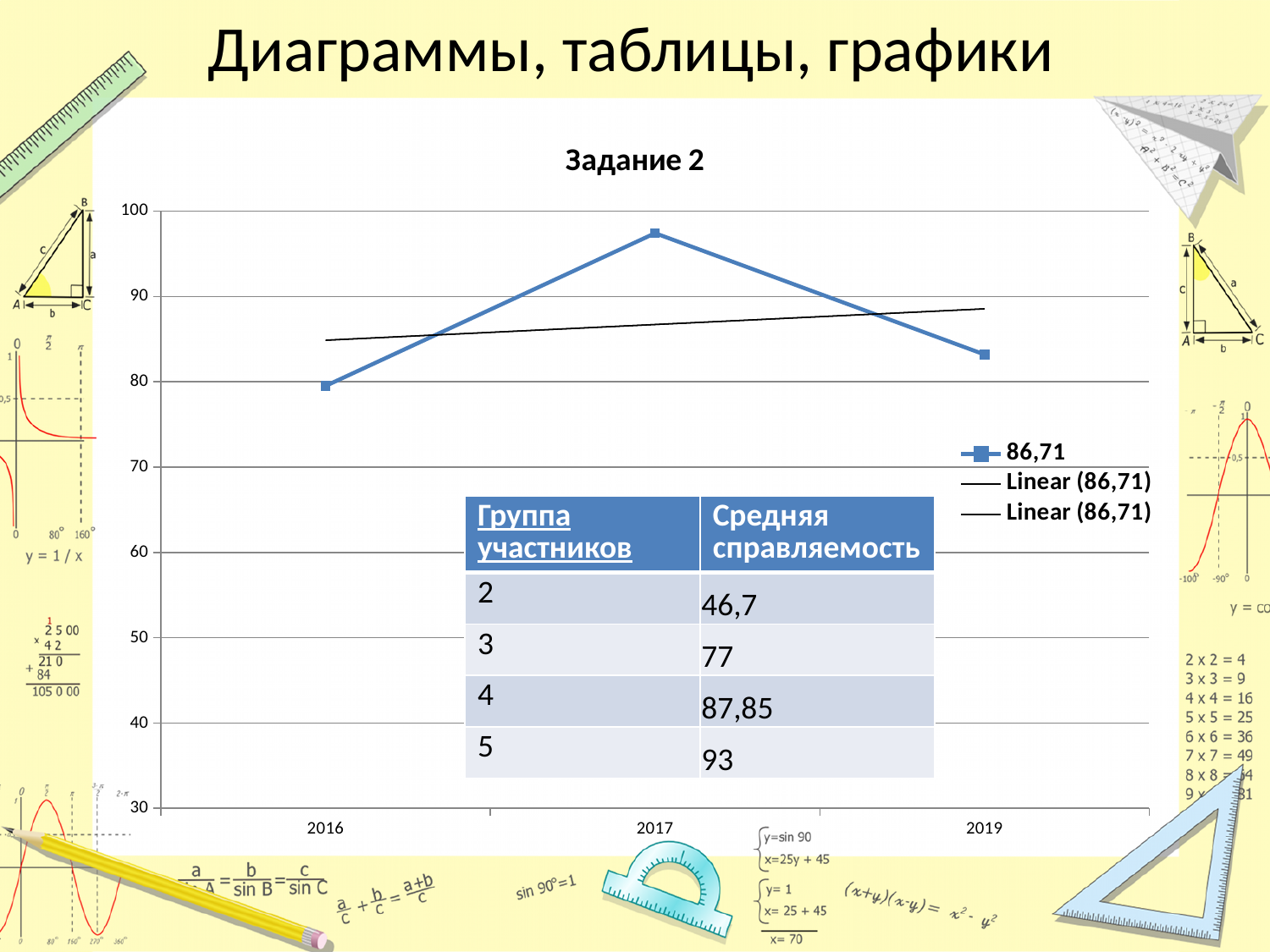
What is the name of the first series listed in the chart legend? 86,71 How many entries does the chart legend list? 3 Does the plotted line rise or fall from 2017 to 2019? fall Which year has the lowest value on the chart? 2016 Is the value for 2016 greater or less than 90? less Is the value for 2019 greater or less than 80? greater What kind of chart is shown on the slide? line chart Is the value for 2017 greater or less than 90? greater Which is larger, the value for 2017 or the value for 2019? 2017 What is the title of the chart? Задание 2 How many data points are plotted on the line in the chart? 3 Which year has the highest value on the chart? 2017